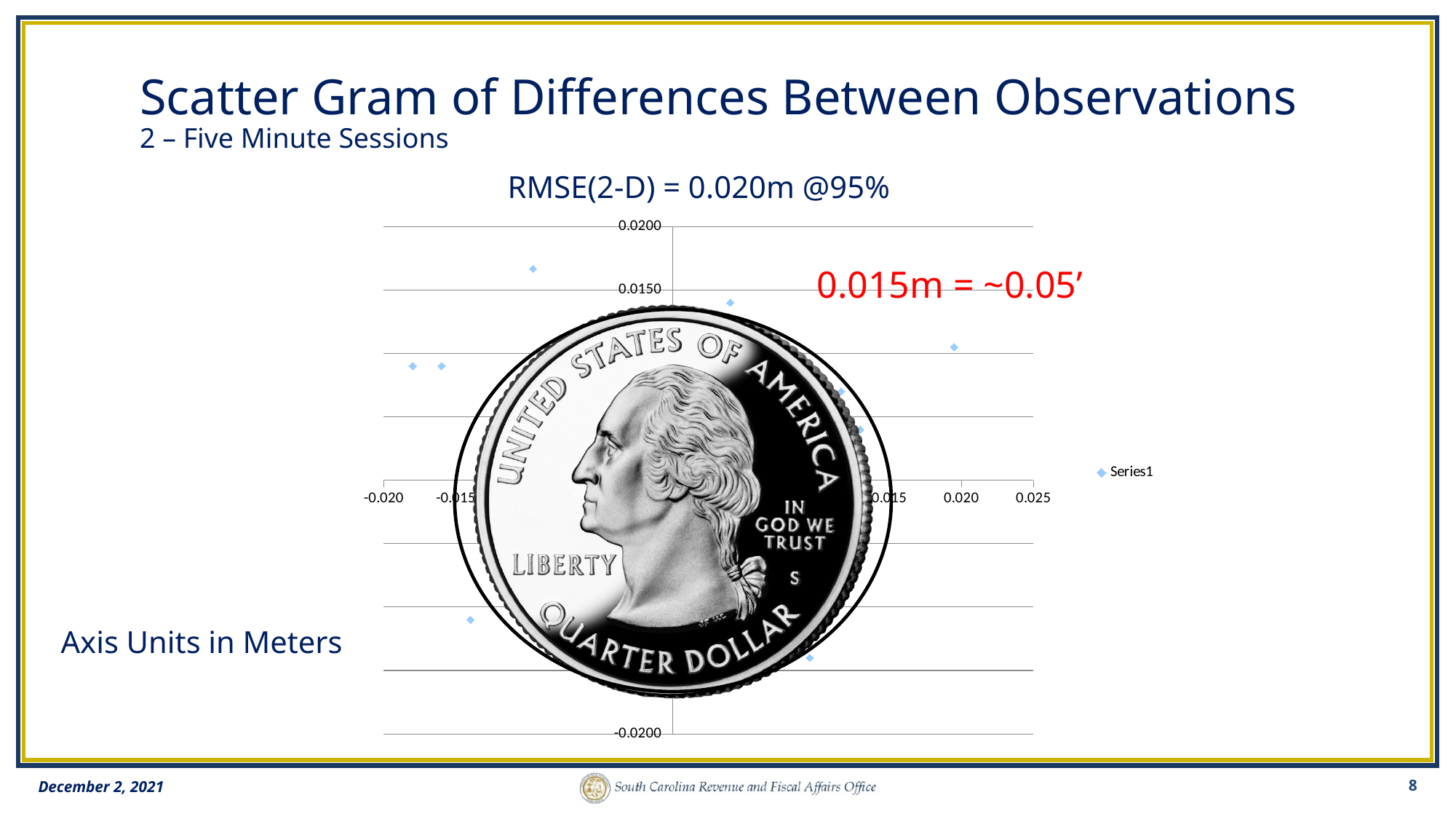
Is the horizontal value of the rightmost plotted point greater or less than 0.015? greater What is the lowest value labelled on the chart's vertical axis? -0.0200 What is the smallest value labelled on the chart's horizontal axis? -0.020 What is the title printed above the chart? RMSE(2-D) = 0.020m @95% What is the largest value labelled on the chart's horizontal axis? 0.025 Are the two points plotted near x = -0.018 and x = -0.016 above or below the 0.0150 gridline? below How many series does the chart's legend list? 1 What is the name of the series shown in the chart legend? Series1 Is the vertical value of the point plotted near x = -0.012 (upper left of the chart) greater or less than 0.0150? greater What is the highest value labelled on the chart's vertical axis? 0.0200 What kind of chart is shown on the slide? Scatter chart